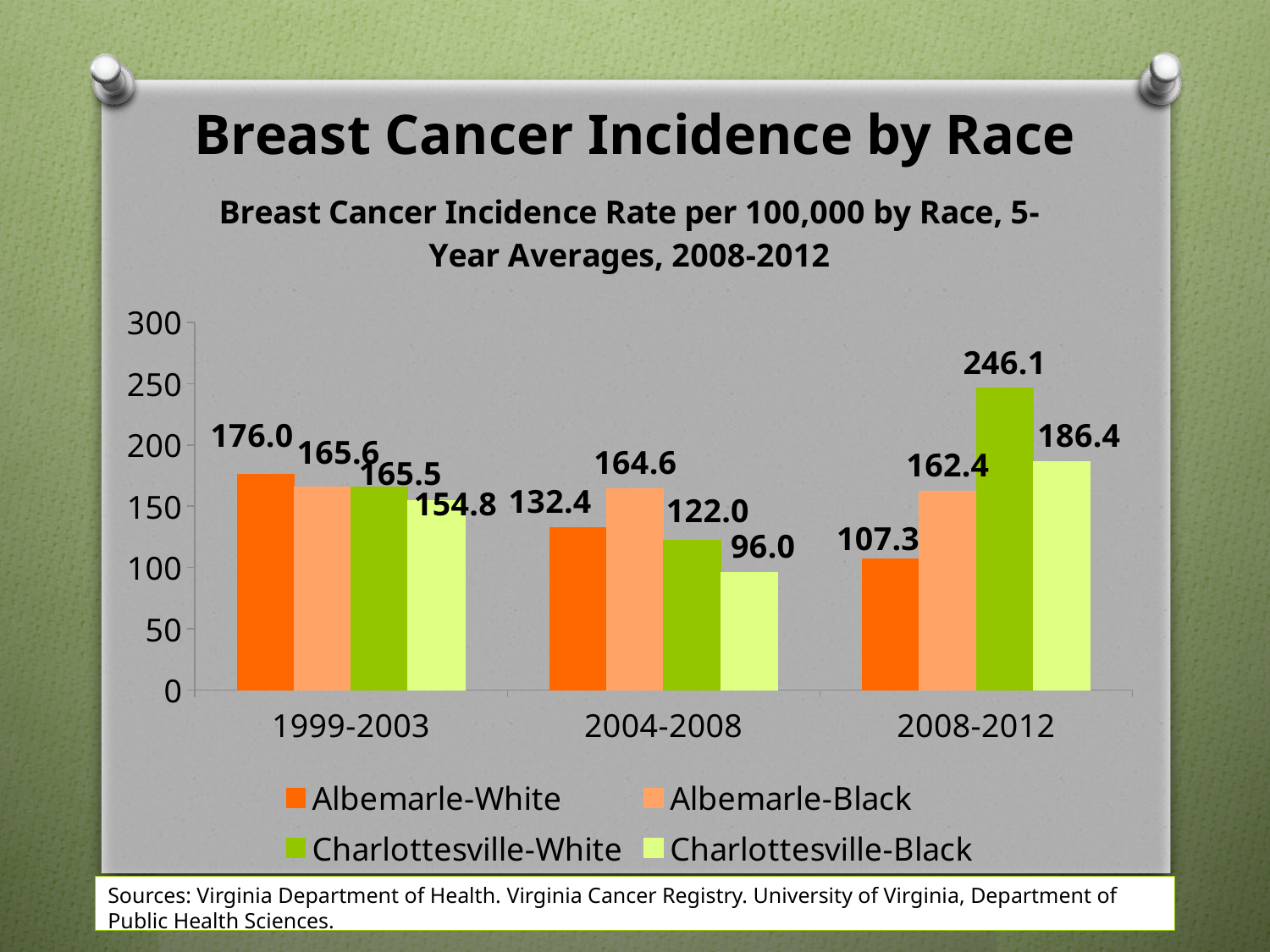
Which series has the lowest value in the 2004-2008 period? Charlottesville-Black What is the value for Charlottesville-White in 2008-2012? 246.1 What is the difference between the Charlottesville-White and Albemarle-White values in 2008-2012? 138.8 Which series has the highest value in the 2008-2012 period? Charlottesville-White What is the value for Albemarle-White in 1999-2003? 176.0 How many series does the legend list? 4 Does the Albemarle-White value rise or fall across the three periods from 1999-2003 to 2008-2012? Fall What kind of chart is shown on the slide? Bar chart What is the value for Albemarle-Black in 2008-2012? 162.4 How many time periods are shown on the x axis? 3 What is the value for Charlottesville-Black in 2004-2008? 96.0 Which is larger in 2004-2008: Albemarle-Black or Albemarle-White? Albemarle-Black